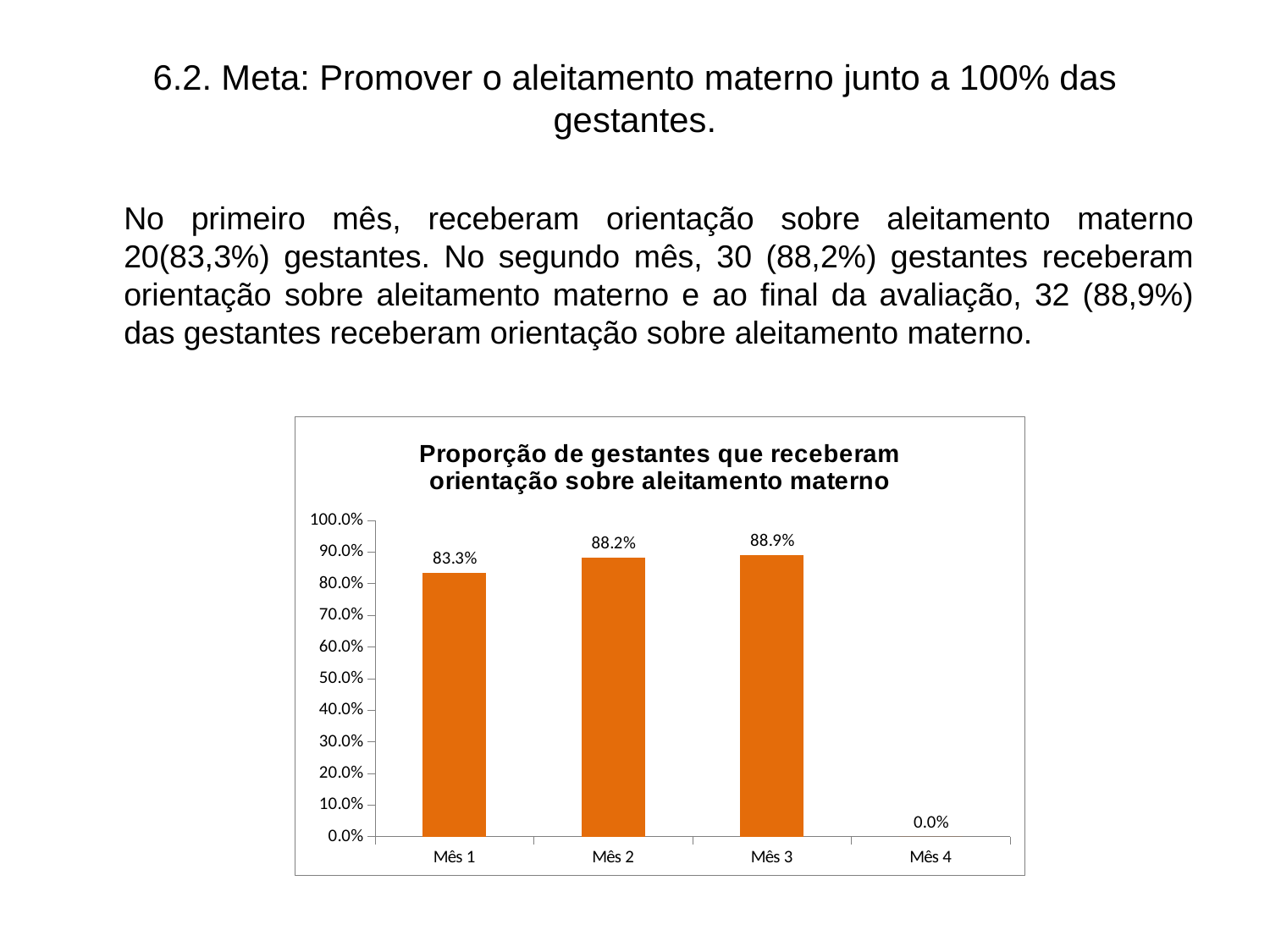
What is the title of the chart? Proporção de gestantes que receberam orientação sobre aleitamento materno Which category has the lowest value? Mês 4 What is the value for Mês 4? 0.0% What kind of chart is shown on the slide? bar chart What is the value for Mês 3? 88.9% Is the value for Mês 2 greater or less than 80.0%? greater What is the value for Mês 2? 88.2% What is the difference between the values for Mês 3 and Mês 1? 5.6% Which category has the highest value? Mês 3 What is the value for Mês 1? 83.3% How many categories are shown on the x axis? 4 Which is larger, the value for Mês 1 or the value for Mês 2? Mês 2